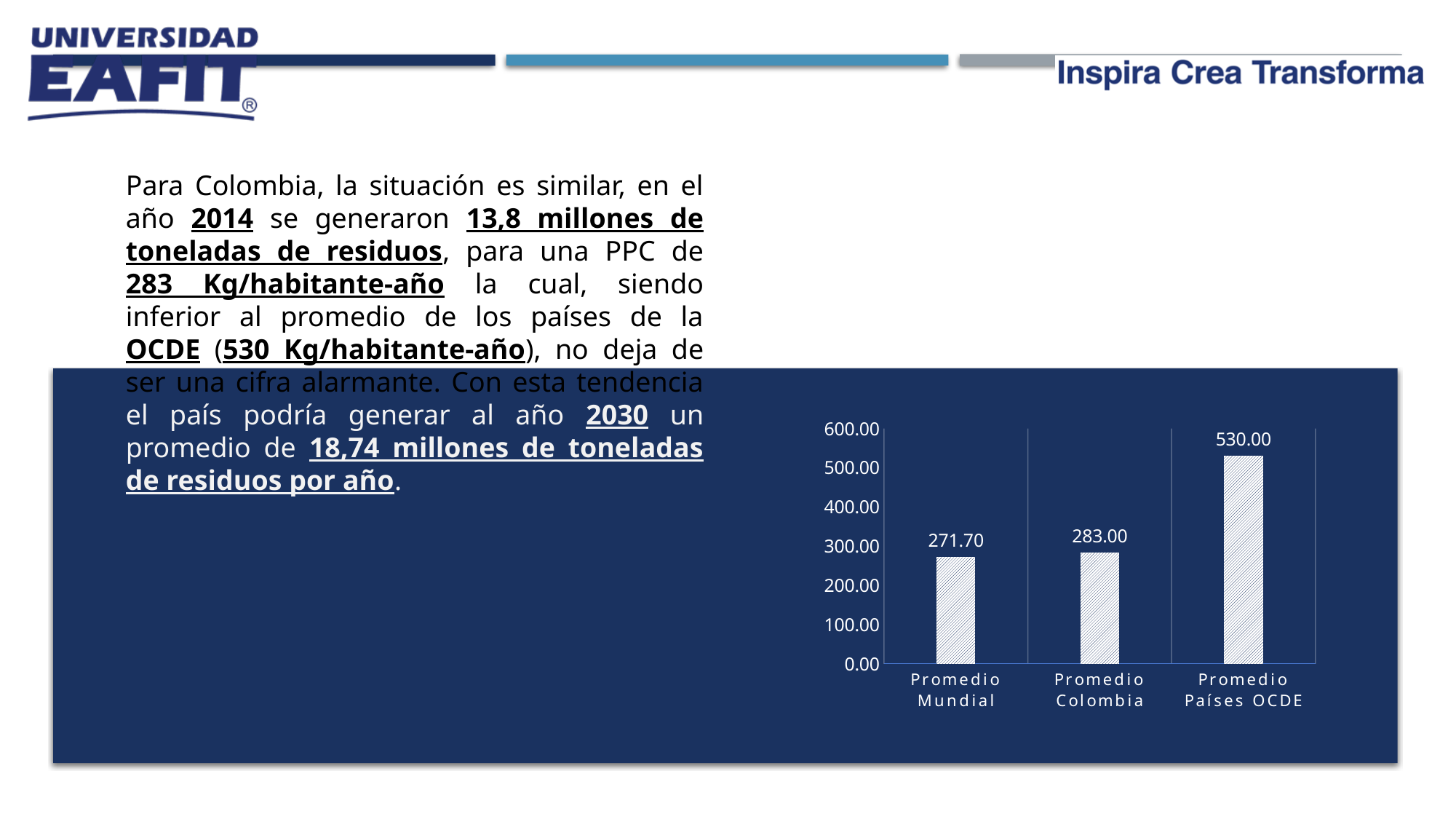
What is the value for Promedio Colombia? 283.00 Is the value for Promedio Mundial greater or less than 300.00? less What is the value for Promedio Países OCDE? 530.00 Which category has the highest value? Promedio Países OCDE Which is larger, Promedio Países OCDE or Promedio Mundial? Promedio Países OCDE What is the difference between Promedio Colombia and Promedio Mundial? 11.30 Which category has the lowest value? Promedio Mundial How many categories are shown in the chart? 3 What is the difference between Promedio Países OCDE and Promedio Colombia? 247.00 Is the value for Promedio Países OCDE greater or less than 500.00? greater What kind of chart is shown on the slide? bar chart What is the value for Promedio Mundial? 271.70